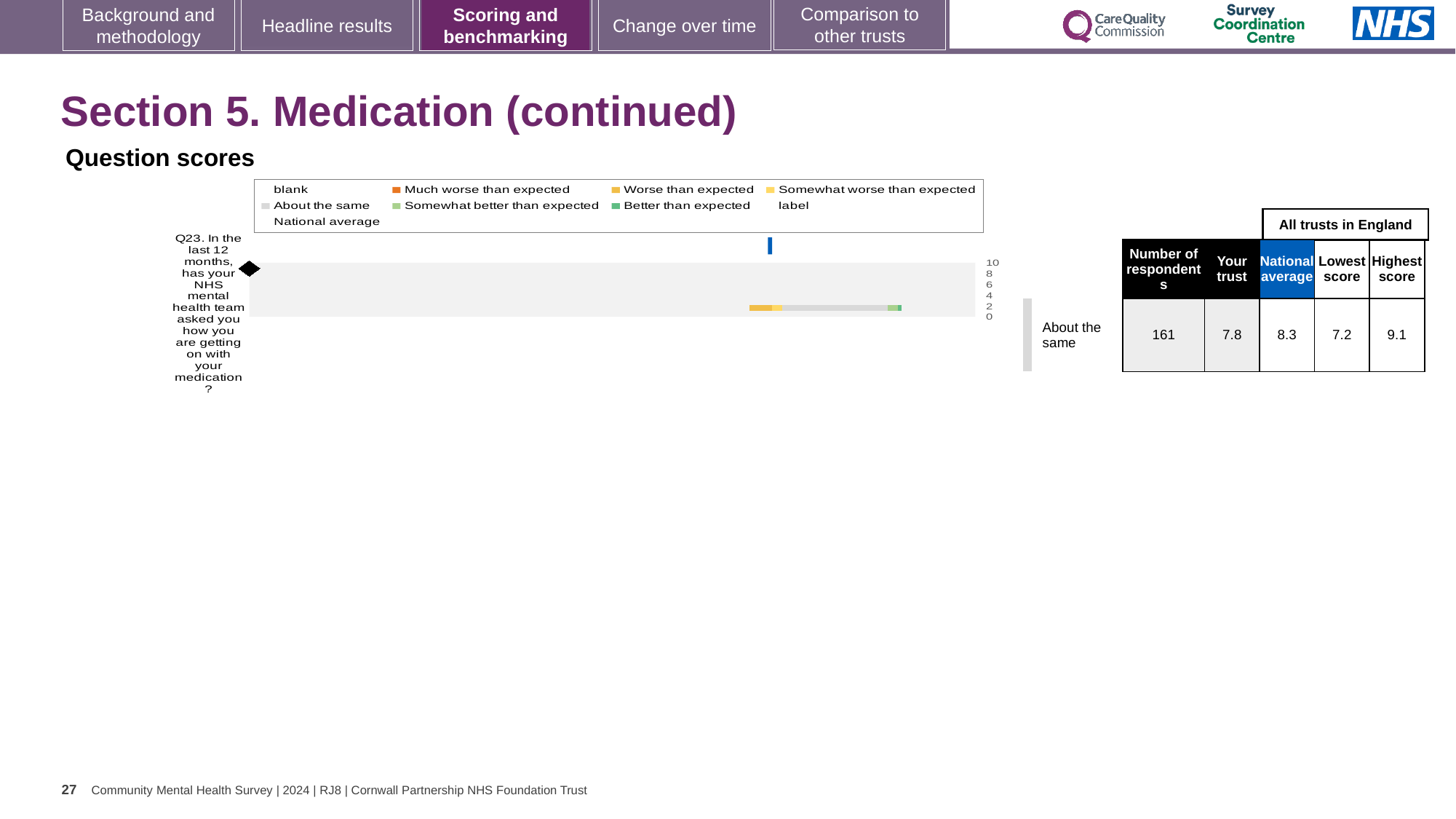
What kind of chart is shown on the slide? bar chart Which question is plotted in the chart? Q23. In the last 12 months, has your NHS mental health team asked you how you are getting on with your medication? What is the 'Your trust' score for Q23? 7.8 How many respondents answered Q23? 161 What benchmarking category is the trust's Q23 score placed in? About the same What is the national average score for Q23? 8.3 How many survey questions are plotted in the chart? 1 What is the highest score among all trusts in England for Q23? 9.1 What is the lowest score among all trusts in England for Q23? 7.2 Which is larger for Q23, the 'Your trust' score or the national average? National average What is the difference between the highest and lowest scores for Q23? 1.9 What is the difference between the national average and the 'Your trust' score for Q23? 0.5